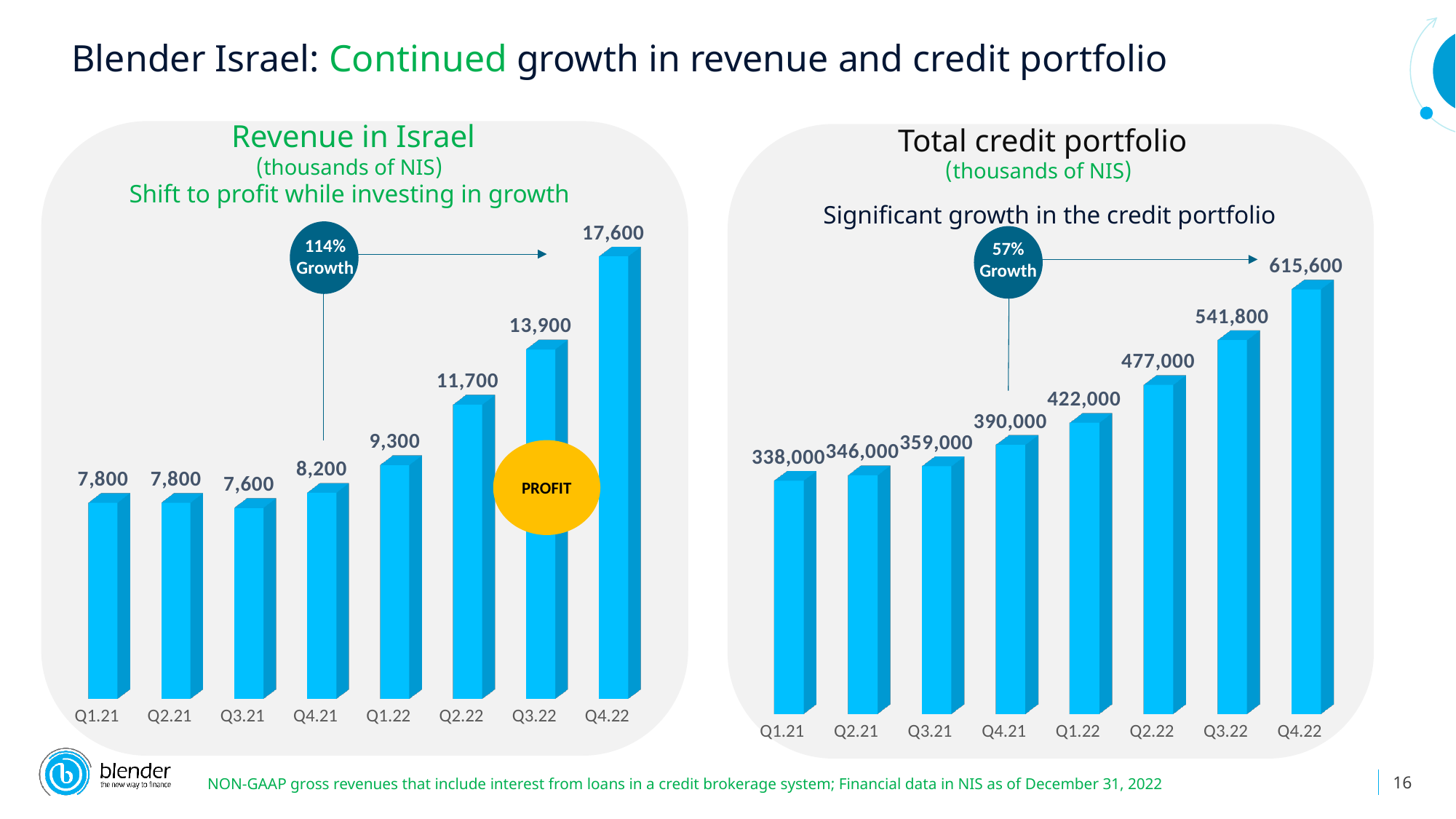
In the Total credit portfolio chart, which quarter has the highest value? Q4.22 In the Total credit portfolio chart, do the values rise or fall from Q1.21 to Q4.22? Rise What kind of chart is the Revenue in Israel chart? Bar chart In the Total credit portfolio chart, what is the difference between the Q4.22 and Q1.21 values? 277,600 In the Revenue in Israel chart, what is the value for Q4.22? 17,600 In the Revenue in Israel chart, what is the difference between the Q4.22 and Q3.22 values? 3,700 In the Revenue in Israel chart, which is larger, the value for Q1.22 or the value for Q4.21? Q1.22 What growth percentage is shown in the callout on the Total credit portfolio chart? 57% In the Revenue in Israel chart, which quarter has the lowest value? Q3.21 How many quarters are shown in the Total credit portfolio chart? 8 In the Revenue in Israel chart, what is the value for Q3.21? 7,600 In the Total credit portfolio chart, what is the value for Q1.22? 422,000